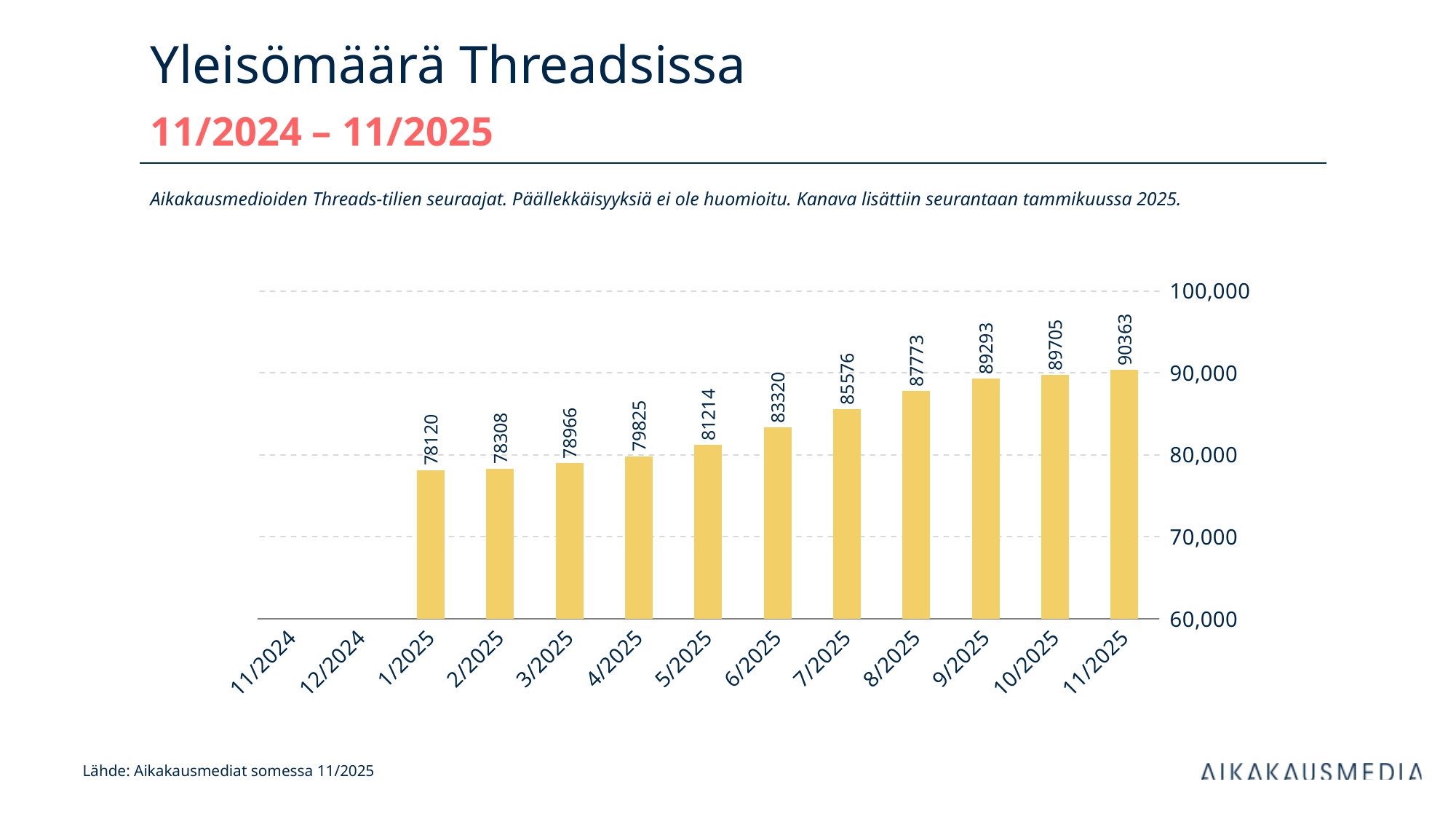
What kind of chart is shown on the slide? bar chart What is the value for 11/2025? 90363 How many months have a bar plotted on the chart? 11 Is the value for 8/2025 greater or less than 90,000? less What is the value for 1/2025? 78120 What is the difference between the values for 10/2025 and 9/2025? 412 Which is larger, the value for 4/2025 or the value for 7/2025? 7/2025 Do the values rise or fall from 1/2025 to 11/2025? rise Which month has the highest value? 11/2025 Which month with a plotted bar has the lowest value? 1/2025 What is the difference between the values for 11/2025 and 1/2025? 12243 What is the value for 6/2025? 83320